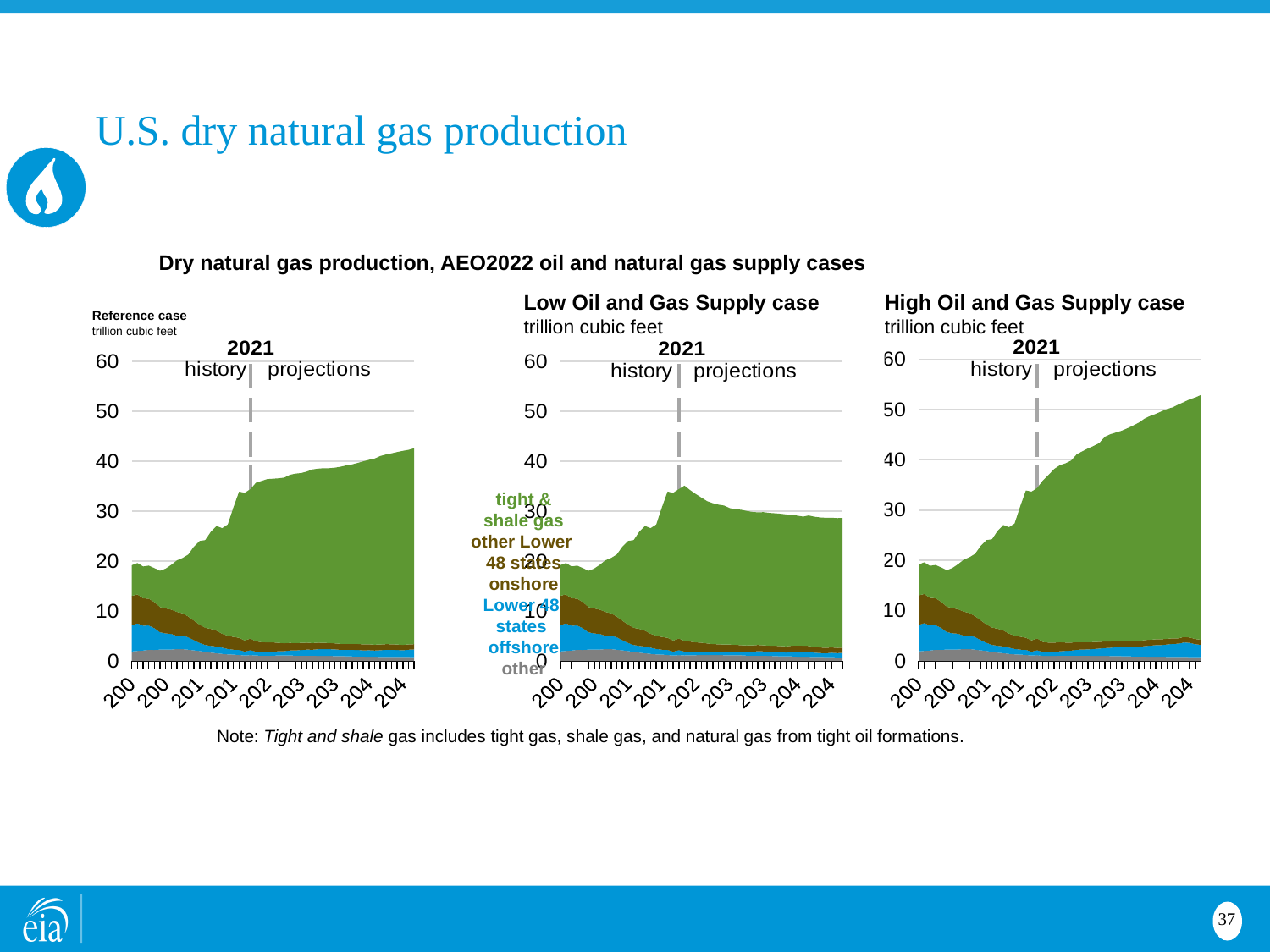
In the Low Oil and Gas Supply case chart, does total dry natural gas production rise or fall over the projection period after 2021? fall What kind of chart is the Reference case chart? stacked area chart In the Reference case chart, is the total dry natural gas production at the end of the projection period greater or less than 40? greater How many series does the legend list for the Low Oil and Gas Supply case chart? 4 What year separates history from projections in the charts? 2021 What unit is used on the y axis of the three charts? trillion cubic feet In the Low Oil and Gas Supply case chart, is the total dry natural gas production at the end of the projection period greater or less than 30? less In the Reference case chart, which series accounts for the largest share of production at the end of the projection period? tight & shale gas In the High Oil and Gas Supply case chart, is the total dry natural gas production at the end of the projection period greater or less than 50? greater In the High Oil and Gas Supply case chart, does total dry natural gas production rise or fall over the projection period after 2021? rise Which chart shows higher total dry natural gas production at the end of the projection period, the Low Oil and Gas Supply case or the High Oil and Gas Supply case? High Oil and Gas Supply case